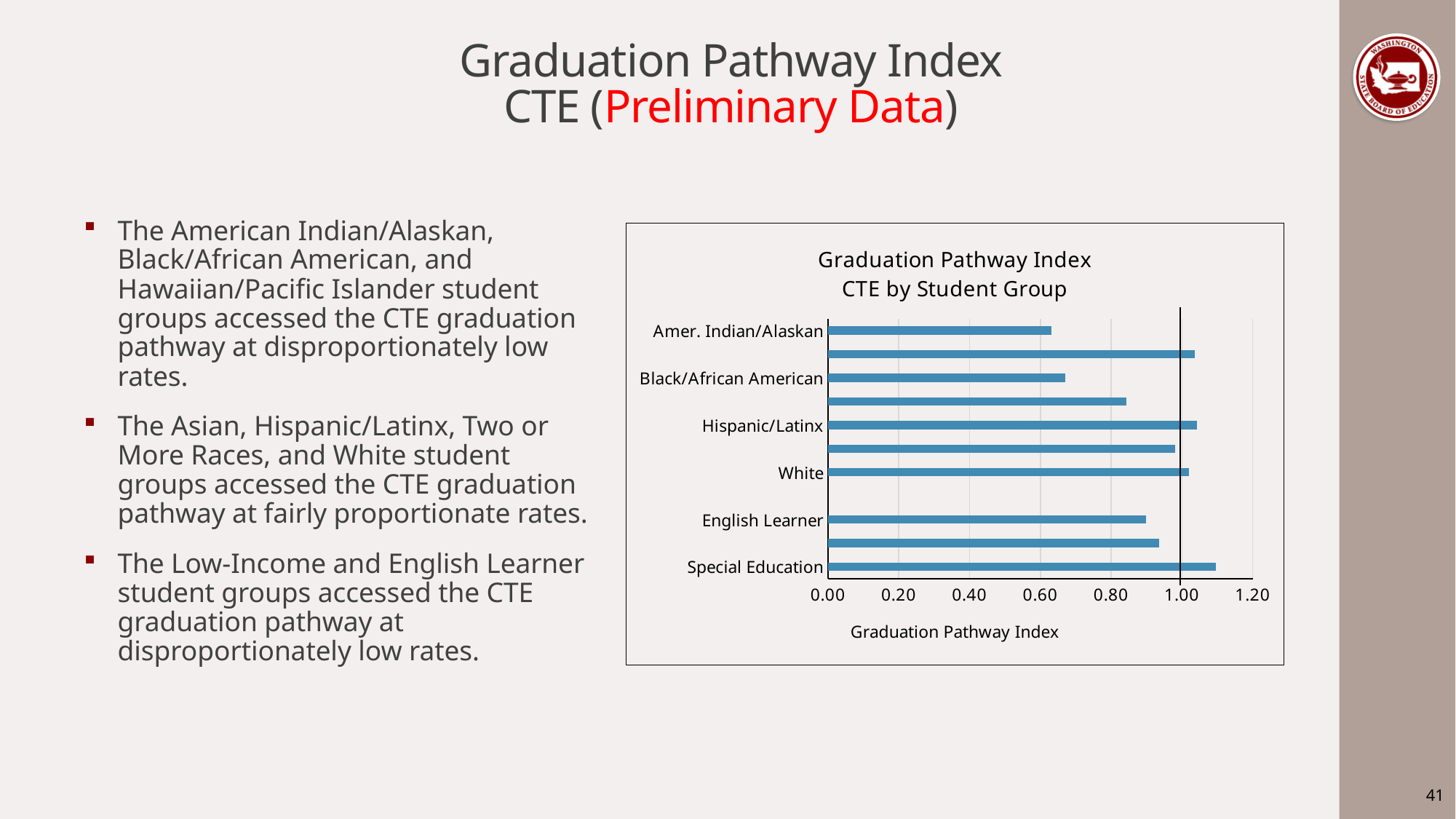
What kind of chart is shown on the slide? bar chart Is the value for Black/African American greater or less than 0.80? less Is the value for Hispanic/Latinx greater or less than 0.80? greater Which has the larger value, Special Education or Amer. Indian/Alaskan? Special Education What is the title of the chart? Graduation Pathway Index CTE by Student Group Is the value for Special Education greater or less than 1.00? greater Which has the larger value, Hispanic/Latinx or Black/African American? Hispanic/Latinx What is the label on the horizontal axis of the chart? Graduation Pathway Index Which has the lower value, Amer. Indian/Alaskan or White? Amer. Indian/Alaskan Which labeled student group has the highest Graduation Pathway Index? Special Education